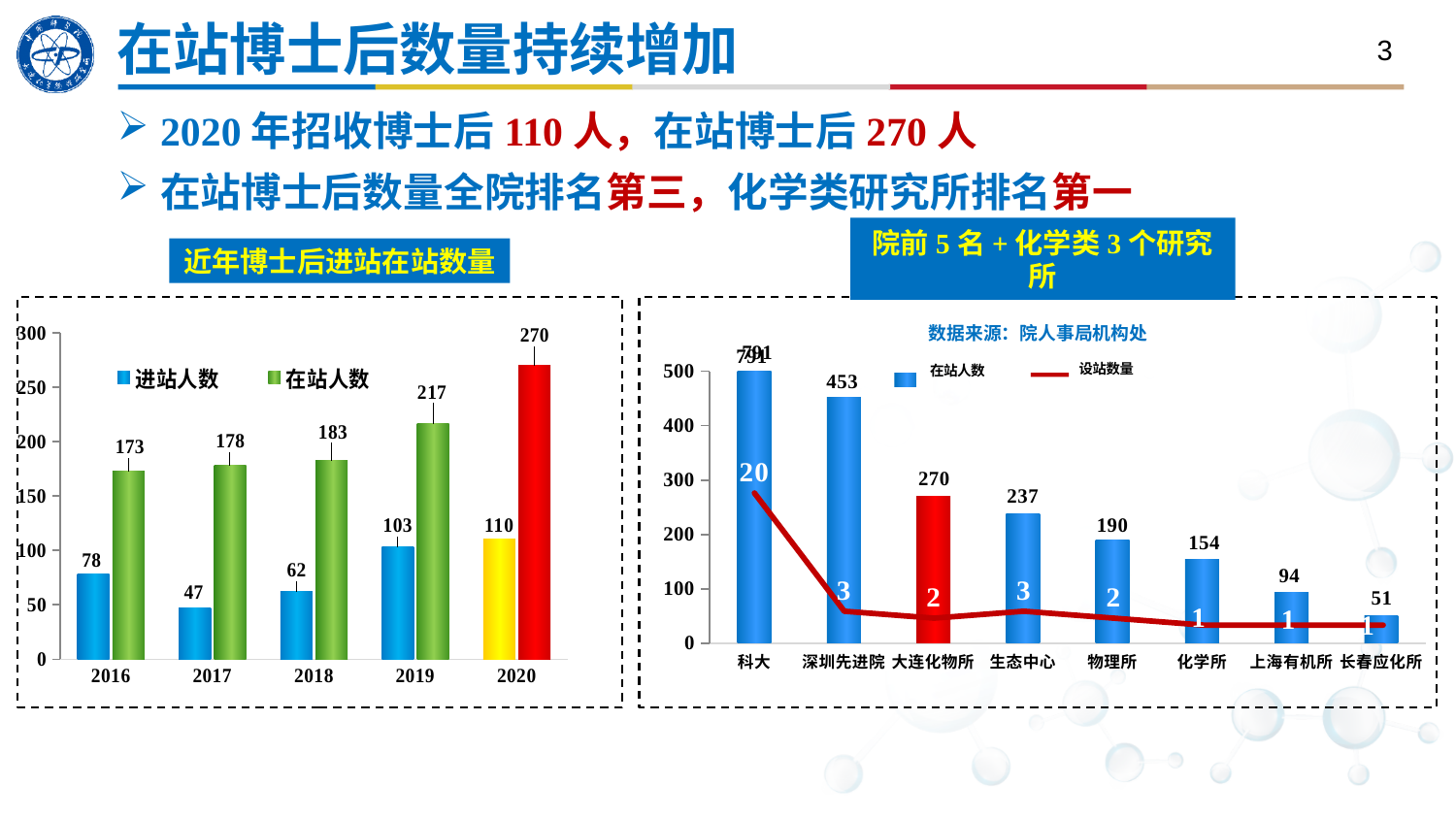
In the left chart (近年博士后进站在站数量), does the 在站人数 series rise or fall from 2016 to 2020? rise In the right chart (院前5名+化学类3个研究所), which is larger, the 在站人数 for 物理所 or for 化学所? 物理所 In the left chart (近年博士后进站在站数量), which year has the lowest 进站人数? 2017 In the left chart (近年博士后进站在站数量), what is the 进站人数 value for 2017? 47 In the left chart (近年博士后进站在站数量), what is the difference between the 在站人数 and 进站人数 values for 2020? 160 In the right chart (院前5名+化学类3个研究所), which institute has the lowest 在站人数? 长春应化所 In the left chart (近年博士后进站在站数量), which year has the highest 在站人数? 2020 In the right chart (院前5名+化学类3个研究所), what is the 设站数量 value for 生态中心? 3 In the left chart (近年博士后进站在站数量), what is the 在站人数 value for 2019? 217 In the left chart (近年博士后进站在站数量), how many series does the legend list? 2 In the right chart (院前5名+化学类3个研究所), how many institutes are shown on the x axis? 8 In the right chart (院前5名+化学类3个研究所), what is the 在站人数 value for 大连化物所? 270